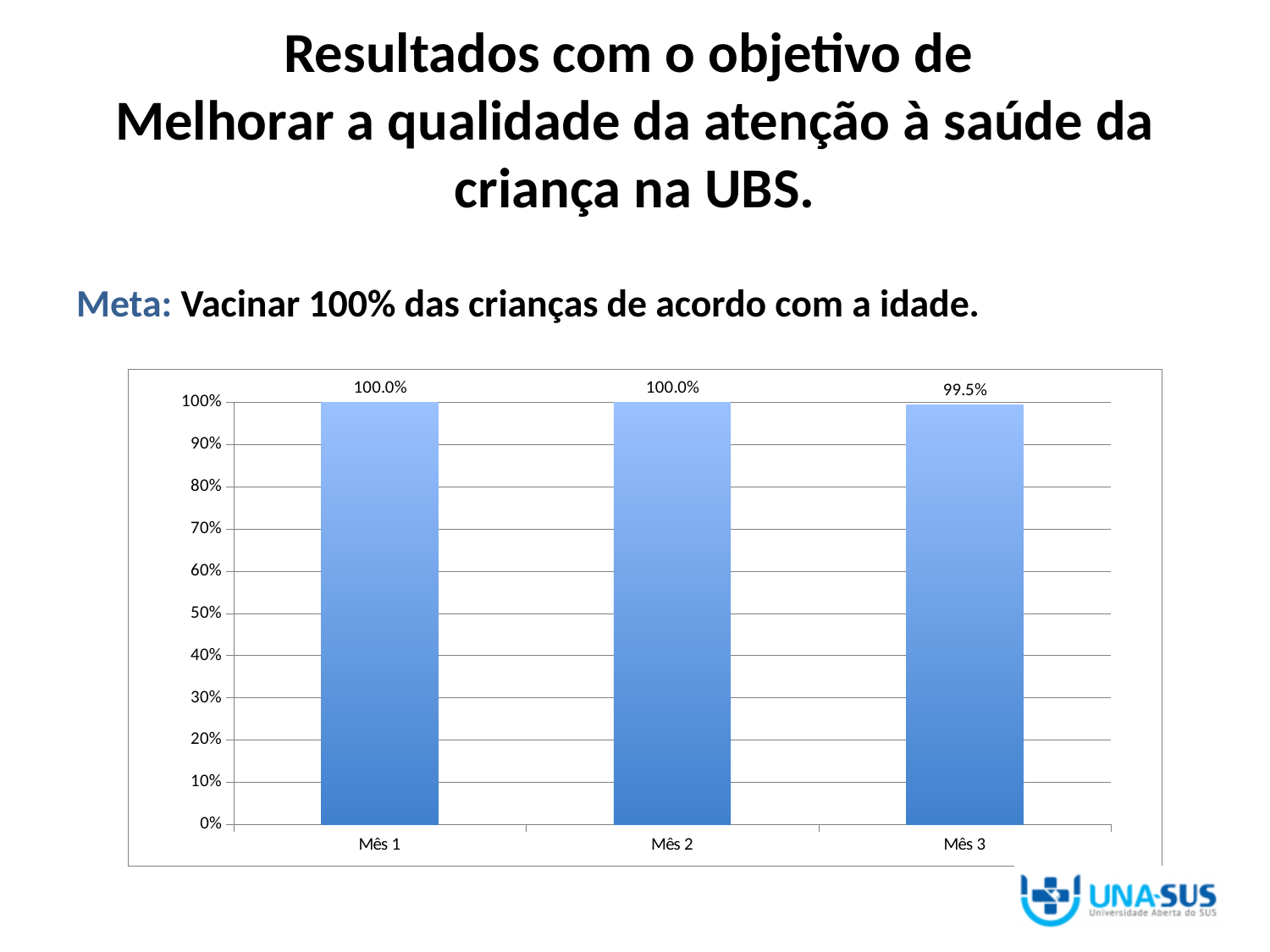
Which is larger, the value for Mês 2 or the value for Mês 3? Mês 2 What is the value for Mês 3? 99.5% What is the label of the first category on the x axis? Mês 1 What is the value for Mês 2? 100.0% Do the values for Mês 1 and Mês 2 differ? No What is the highest tick label on the y axis? 100% Is the value for Mês 3 greater or less than 90%? greater Which month has the lowest value? Mês 3 How many categories are shown on the x axis? 3 What kind of chart is shown on the slide? bar chart What is the value for Mês 1? 100.0% What is the difference between the values for Mês 1 and Mês 3? 0.5%